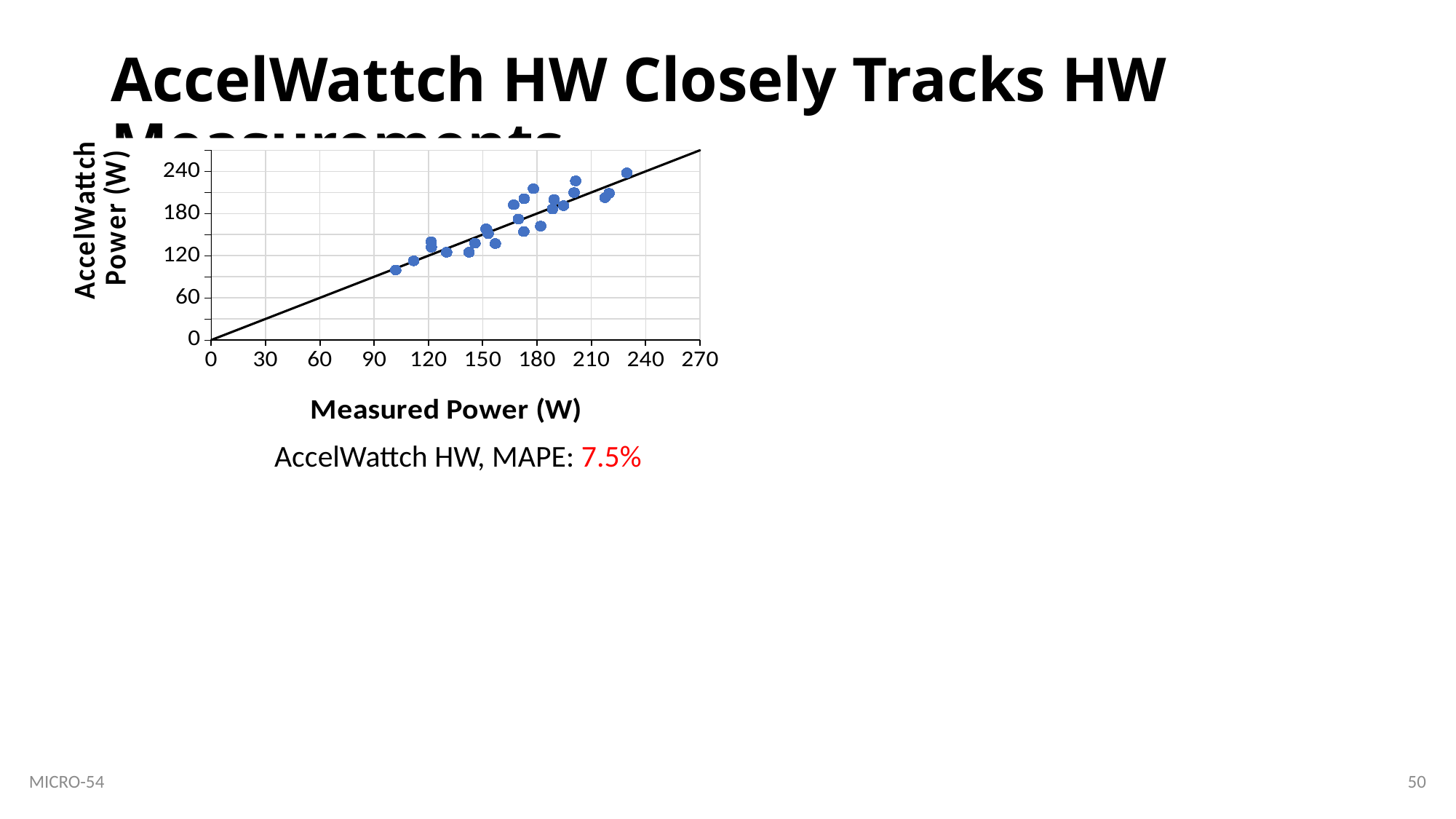
Do the plotted AccelWattch Power values rise or fall as Measured Power increases along the x axis? rise What kind of chart is shown on the slide? scatter plot What is the label of the x axis of the chart? Measured Power (W) Is the lowest AccelWattch Power value plotted greater or less than 60? greater What is the label of the y axis of the chart? AccelWattch Power (W) Is the lowest AccelWattch Power value plotted greater or less than 120? less Is the highest AccelWattch Power value plotted greater or less than 180? greater What MAPE value is reported for AccelWattch HW below the chart? 7.5%